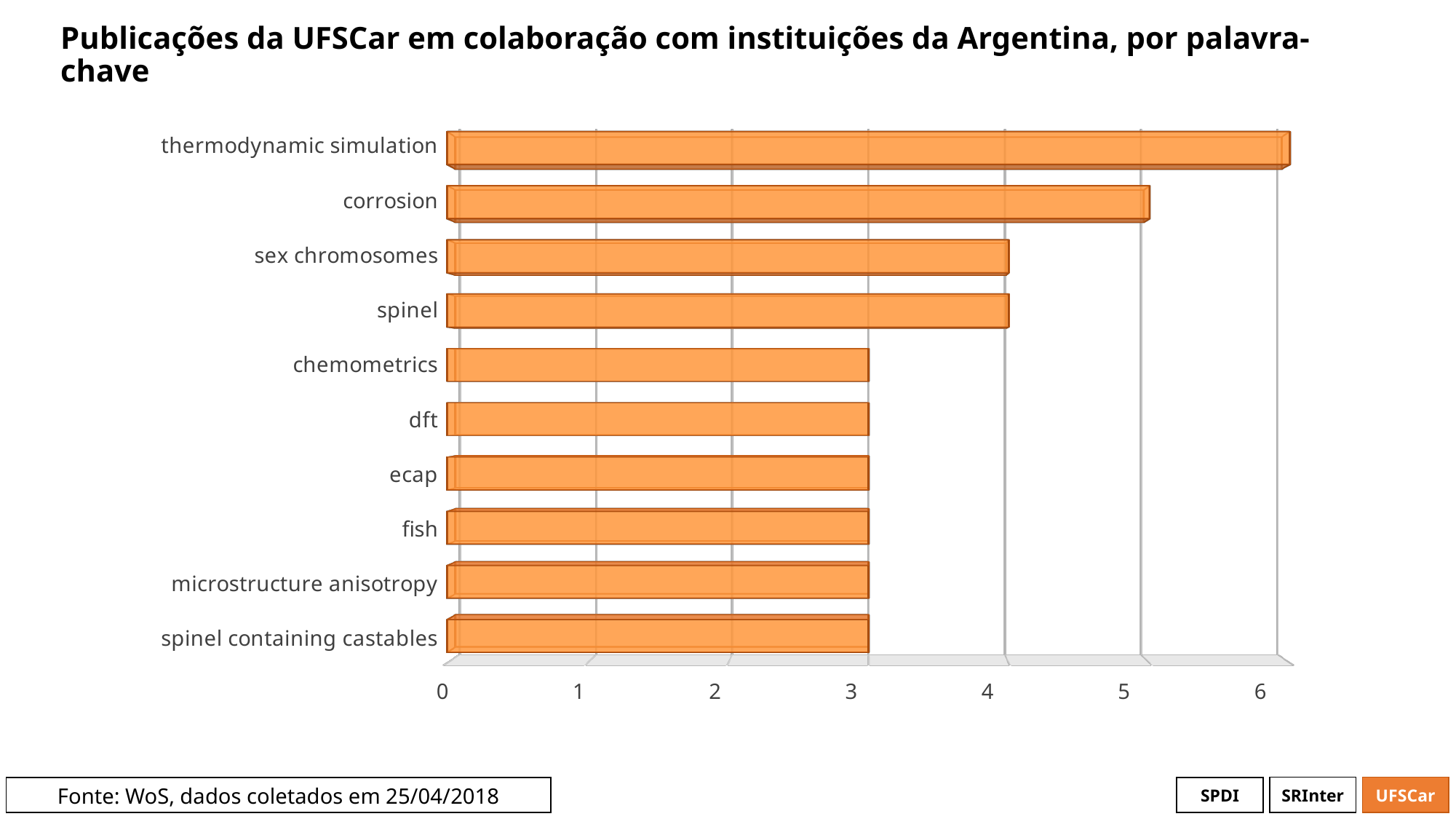
What is the title of the chart? Publicações da UFSCar em colaboração com instituições da Argentina, por palavra-chave Is the value for chemometrics greater or less than 4? less Is the value for corrosion greater or less than 4? greater Which has more publications, corrosion or spinel? corrosion How many publications are shown for corrosion? 5 How many publications are shown for dft? 3 Which keyword has the highest number of publications? thermodynamic simulation What is the difference in publications between thermodynamic simulation and fish? 3 What kind of chart is shown on the slide? bar chart How many publications are shown for sex chromosomes? 4 How many publications are shown for thermodynamic simulation? 6 How many keywords (categories) are shown in the chart? 10